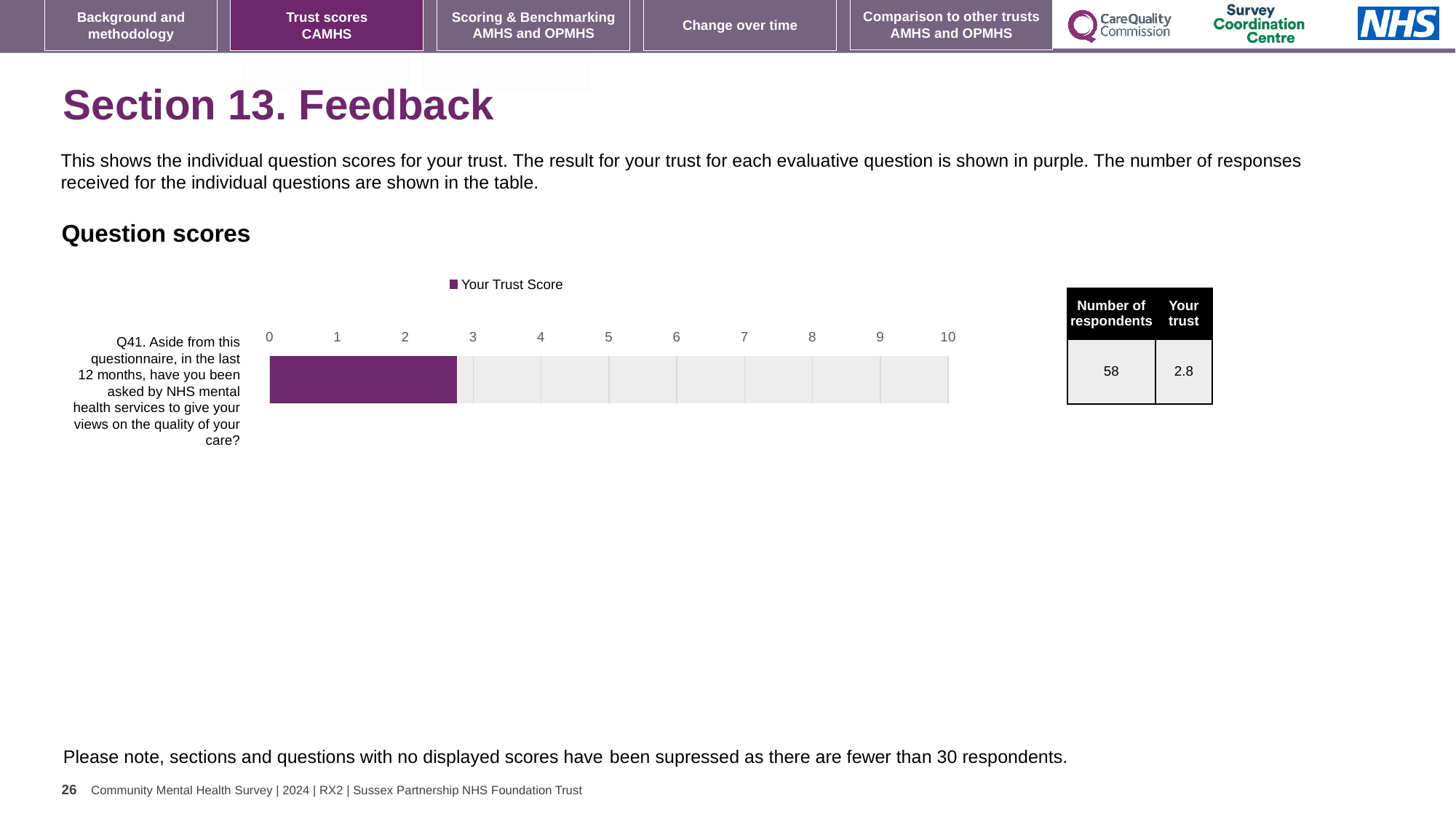
Is the trust score for Q41 greater or less than 2? greater Is the trust score for Q41 greater or less than 5? less What colour is the bar for Q41 in the Question scores chart? purple What kind of chart is shown under 'Question scores'? bar chart According to the table beside the chart, how many respondents answered Q41? 58 How many questions (categories) are plotted in the Question scores chart? 1 Is the trust score for Q41 greater or less than 3? less How many series does the legend of the Question scores chart list? 1 What is the maximum value shown on the x axis of the Question scores chart? 10 According to the table beside the chart, what is the trust score for Q41? 2.8 What is the name of the series shown in the legend of the Question scores chart? Your Trust Score